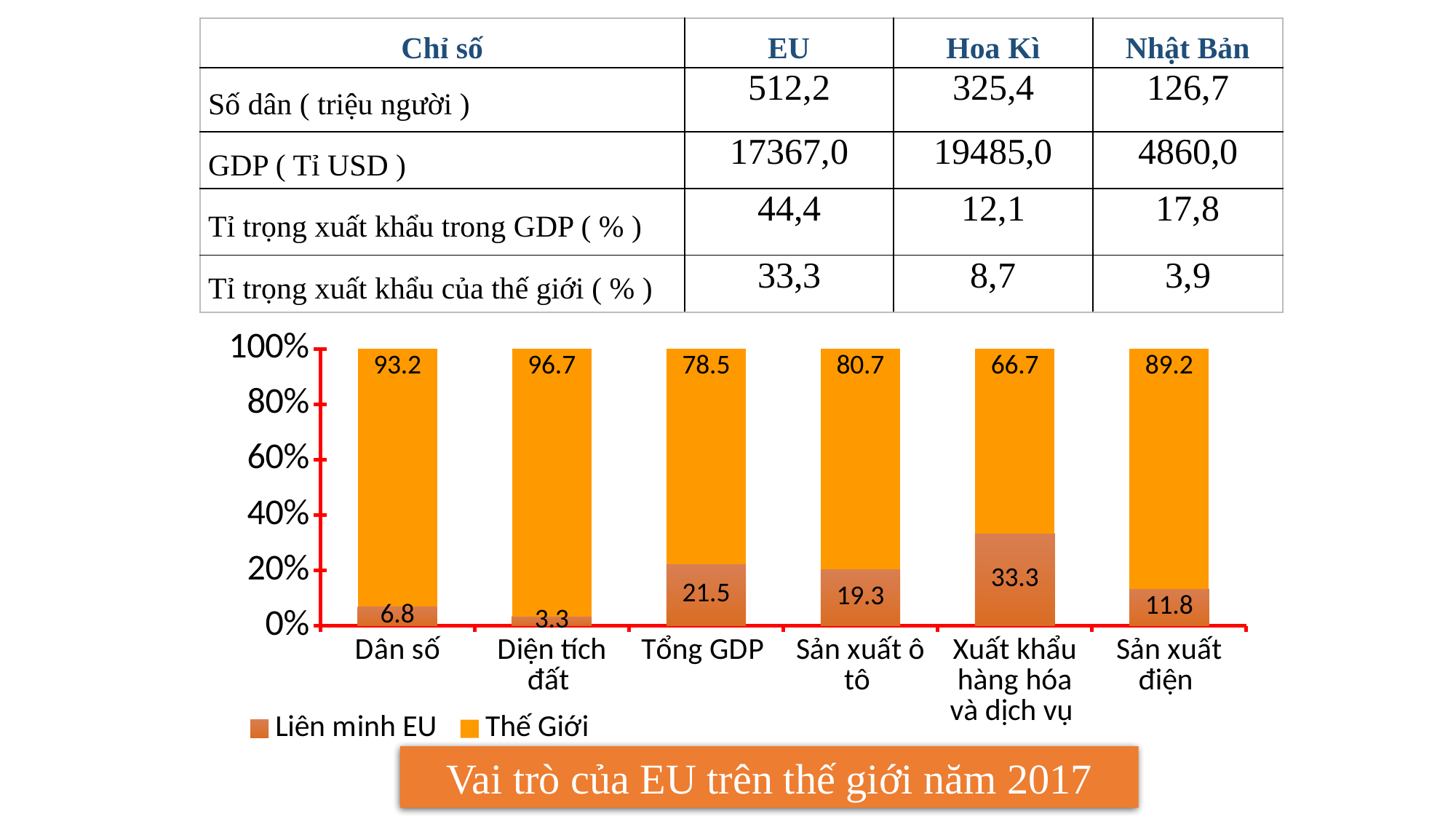
How many categories are shown on the x axis of the chart? 6 In which category is the Liên minh EU value lowest? Diện tích đất What kind of chart is shown on the slide? Stacked bar chart What is the value for Liên minh EU in the Tổng GDP category? 21.5 In which category is the Liên minh EU value highest? Xuất khẩu hàng hóa và dịch vụ What is the difference between the Thế Giới value and the Liên minh EU value in the Sản xuất điện category? 77.4 What is the value for Thế Giới in the Dân số category? 93.2 What is the value for Liên minh EU in the Xuất khẩu hàng hóa và dịch vụ category? 33.3 What is the title shown below the chart? Vai trò của EU trên thế giới năm 2017 Which is larger: the Liên minh EU value for Tổng GDP or for Sản xuất ô tô? Tổng GDP How many series does the chart legend list? 2 What is the total of the stacked bar for Sản xuất ô tô? 100